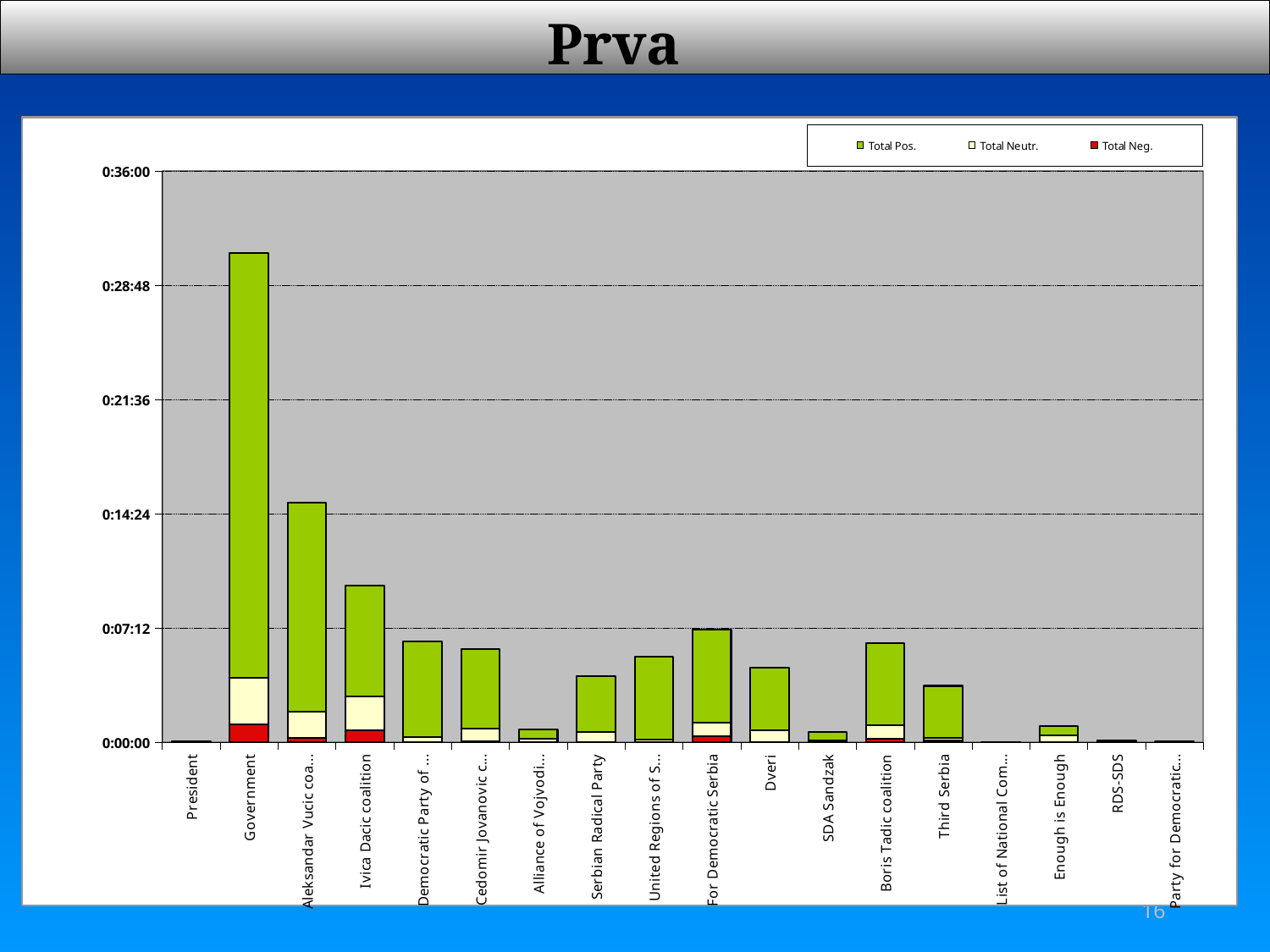
Which has the larger total bar, Boris Tadic coalition or Third Serbia? Boris Tadic coalition Which has the larger total bar, Government or Ivica Dacic coalition? Government How many series does the legend list? 3 Is the total value for Dveri greater or less than 0:07:12? less Is the total value for Government greater or less than 0:28:48? greater What kind of chart is shown on the slide? Stacked bar chart Is the total value for Ivica Dacic coalition greater or less than 0:07:12? greater Which category has the tallest bar? Government Which has the larger total bar, Dveri or SDA Sandzak? Dveri What are the three series named in the legend? Total Pos., Total Neutr., Total Neg. What colour represents the Total Neg. series in the chart? Red